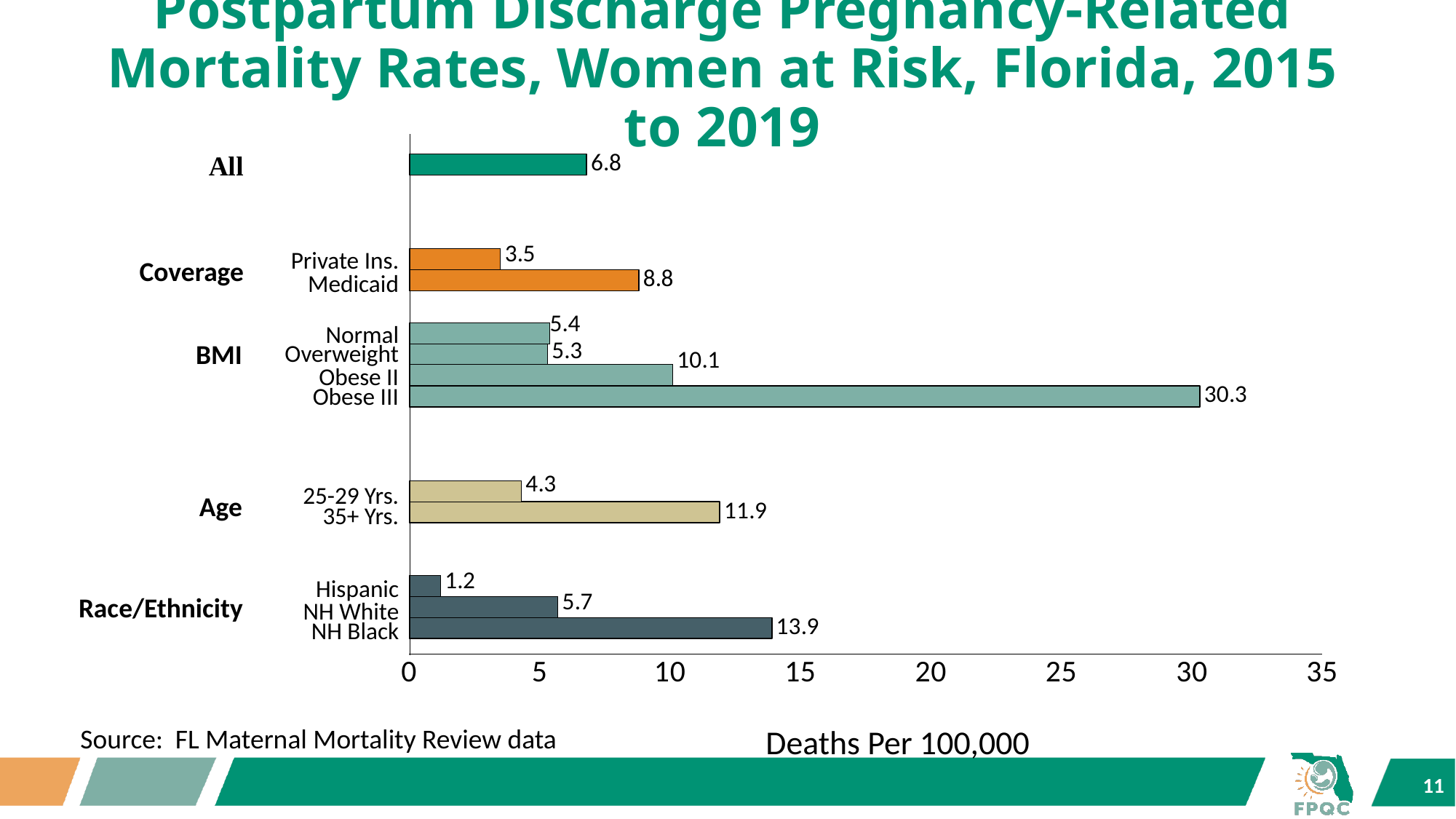
What kind of chart is shown on the slide? Bar chart Which category has the highest mortality rate on the chart? Obese III Which has a higher mortality rate, NH White or NH Black? NH Black What is the mortality rate for women with Medicaid coverage? 8.8 What is the postpartum discharge pregnancy-related mortality rate for All women? 6.8 Is the mortality rate for Obese II greater or less than 10? greater What unit is the x axis measured in, according to the axis label? Deaths Per 100,000 What is the mortality rate for NH Black women? 13.9 Which category has the lowest mortality rate on the chart? Hispanic What is the difference in mortality rate between Medicaid and Private Ins.? 5.3 What is the mortality rate for women in the Obese III BMI category? 30.3 What is the difference in mortality rate between women 35+ Yrs. and women 25-29 Yrs.? 7.6